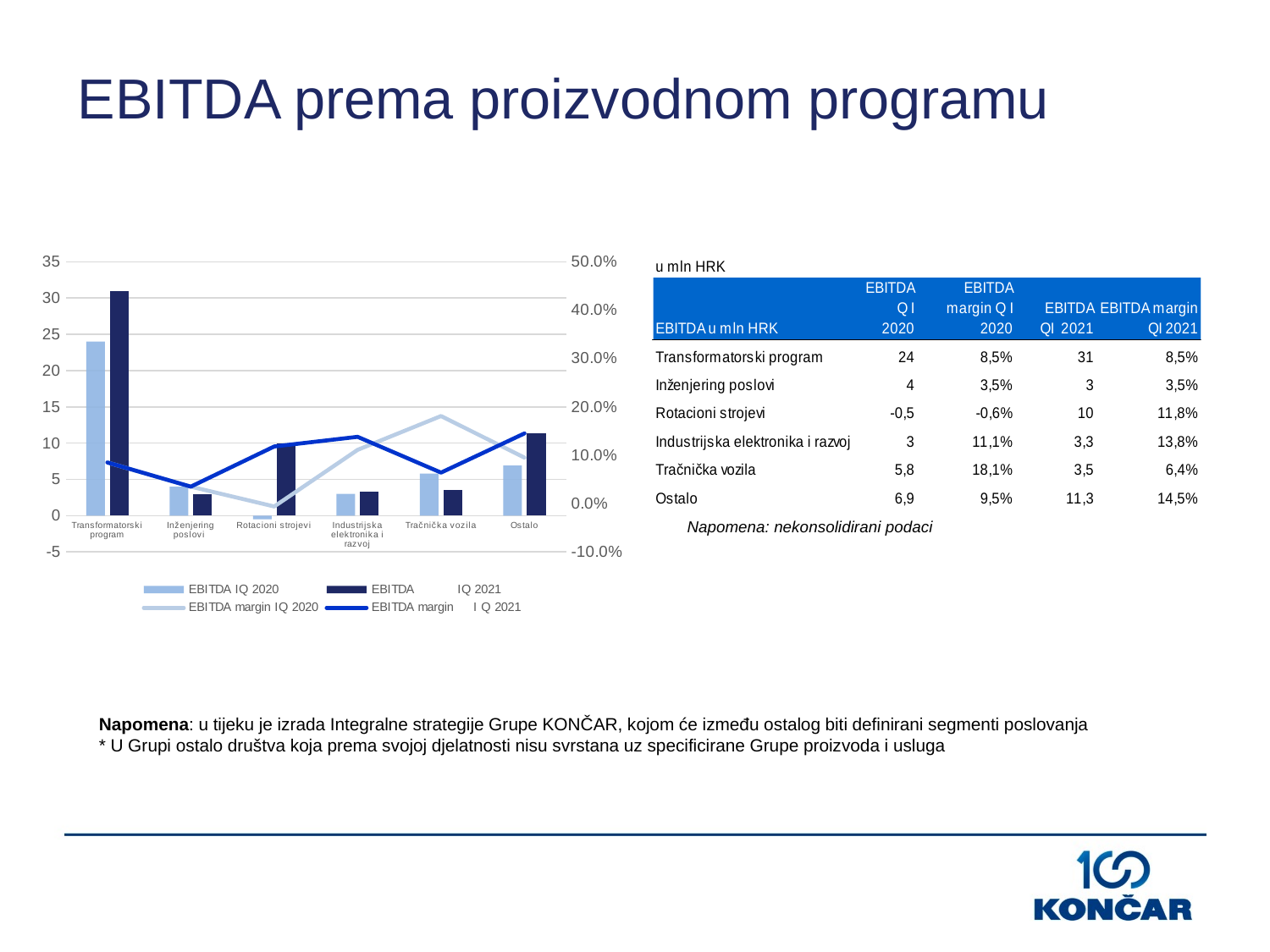
Is the EBITDA IQ 2021 value for Transformatorski program greater or less than 25? greater What is the EBITDA margin IQ 2020 value for Tračnička vozila? 18,1% Does the EBITDA margin IQ 2021 line rise or fall from Tračnička vozila to Ostalo? rise How many product programme categories are shown on the x axis of the chart? 6 How many series does the chart legend list? 4 What is the difference between EBITDA IQ 2021 and EBITDA IQ 2020 for Transformatorski program? 7 What kind of chart is shown on the slide? Combined bar and line chart Which category has the lowest EBITDA IQ 2020 bar? Rotacioni strojevi Which is larger: the EBITDA IQ 2021 bar for Ostalo or for Rotacioni strojevi? Ostalo What is the title of the slide containing the chart? EBITDA prema proizvodnom programu Which category has the highest EBITDA IQ 2021 bar? Transformatorski program What is the EBITDA IQ 2021 value for Transformatorski program? 31